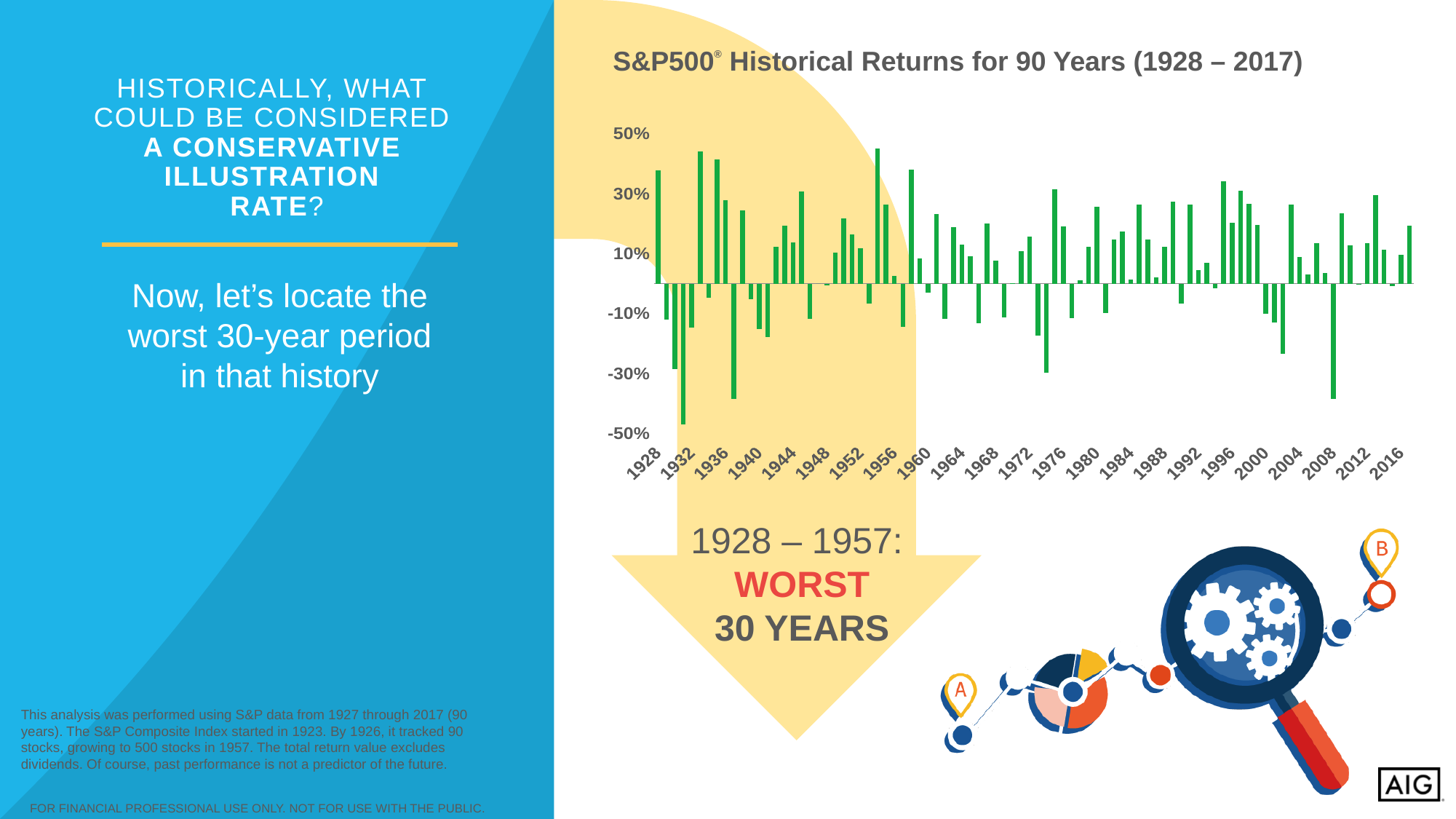
Which year has the higher return, 1932 or 1933? 1933 Which year has the lower return, 1931 or 2008? 1931 What kind of chart is shown on the slide? Bar chart What is the title of the chart? S&P500 Historical Returns for 90 Years (1928 – 2017) Which year has the lowest return on the chart? 1931 What is the highest value shown on the chart's vertical axis? 50% Is the return for 1928 greater or less than 30%? greater Is the return for 1937 greater or less than -30%? less How many years of returns does the chart cover? 90 Is the return for 1931 greater or less than -30%? less